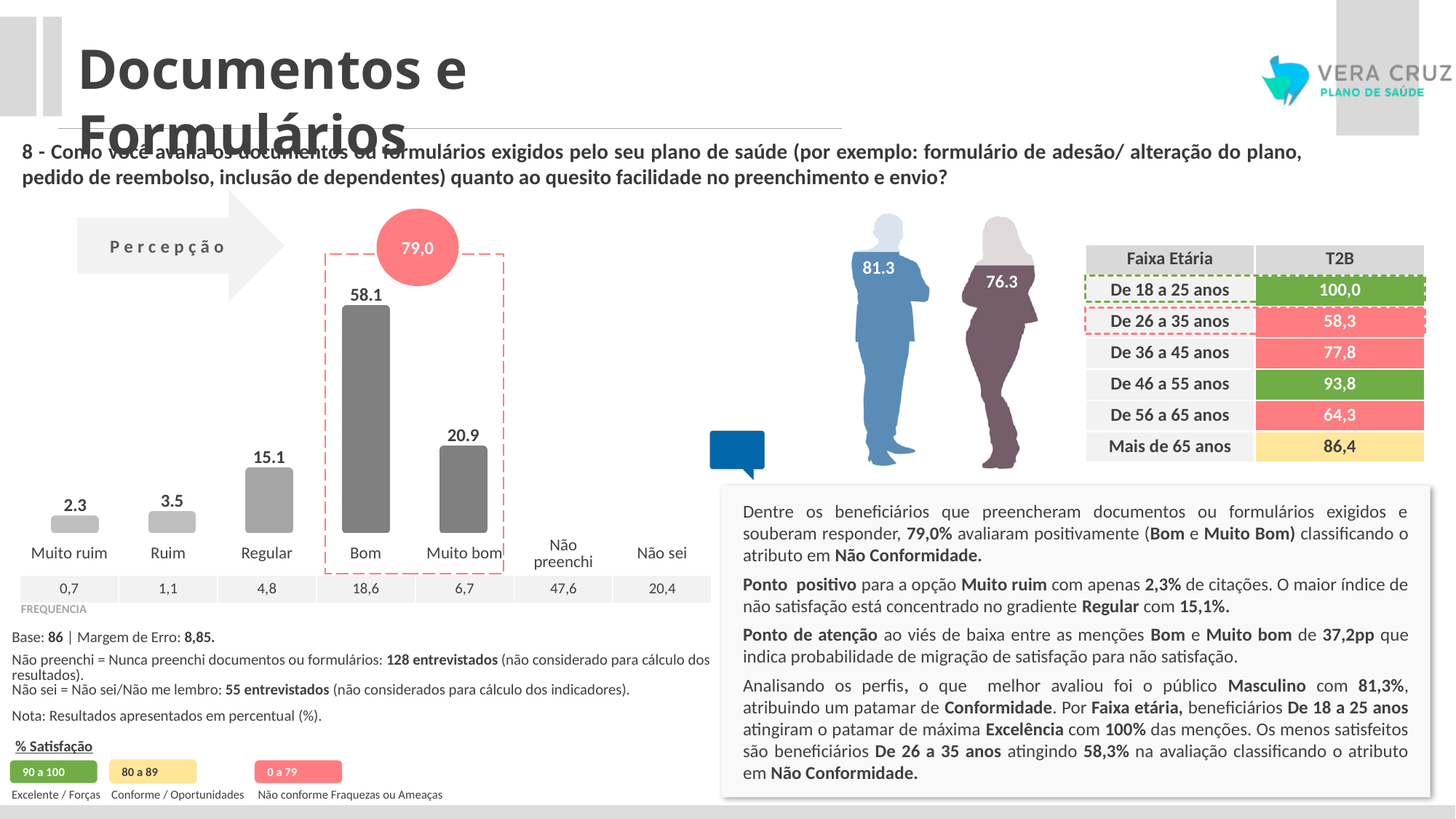
What is the value shown for the Bom bar in the bar chart? 58.1 In the Faixa Etária table, which age group has the highest T2B value? De 18 a 25 anos What is the difference between the Bom and Muito bom values in the bar chart? 37.2 What is the combined value of the Bom and Muito bom bars, as shown in the circle above the chart? 79,0 What is the value shown for the Regular bar in the bar chart? 15.1 What type of chart is used to show the Percepção results? bar chart What is the FREQUENCIA value shown under the Não preenchi category? 47,6 Which category has the highest bar in the bar chart? Bom In the Faixa Etária table, what is the T2B value for De 46 a 55 anos? 93,8 What is the value shown for the Muito bom bar in the bar chart? 20.9 Which category has the lowest bar among the plotted bars in the bar chart? Muito ruim Which is larger in the bar chart, the value for Ruim or the value for Regular? Regular